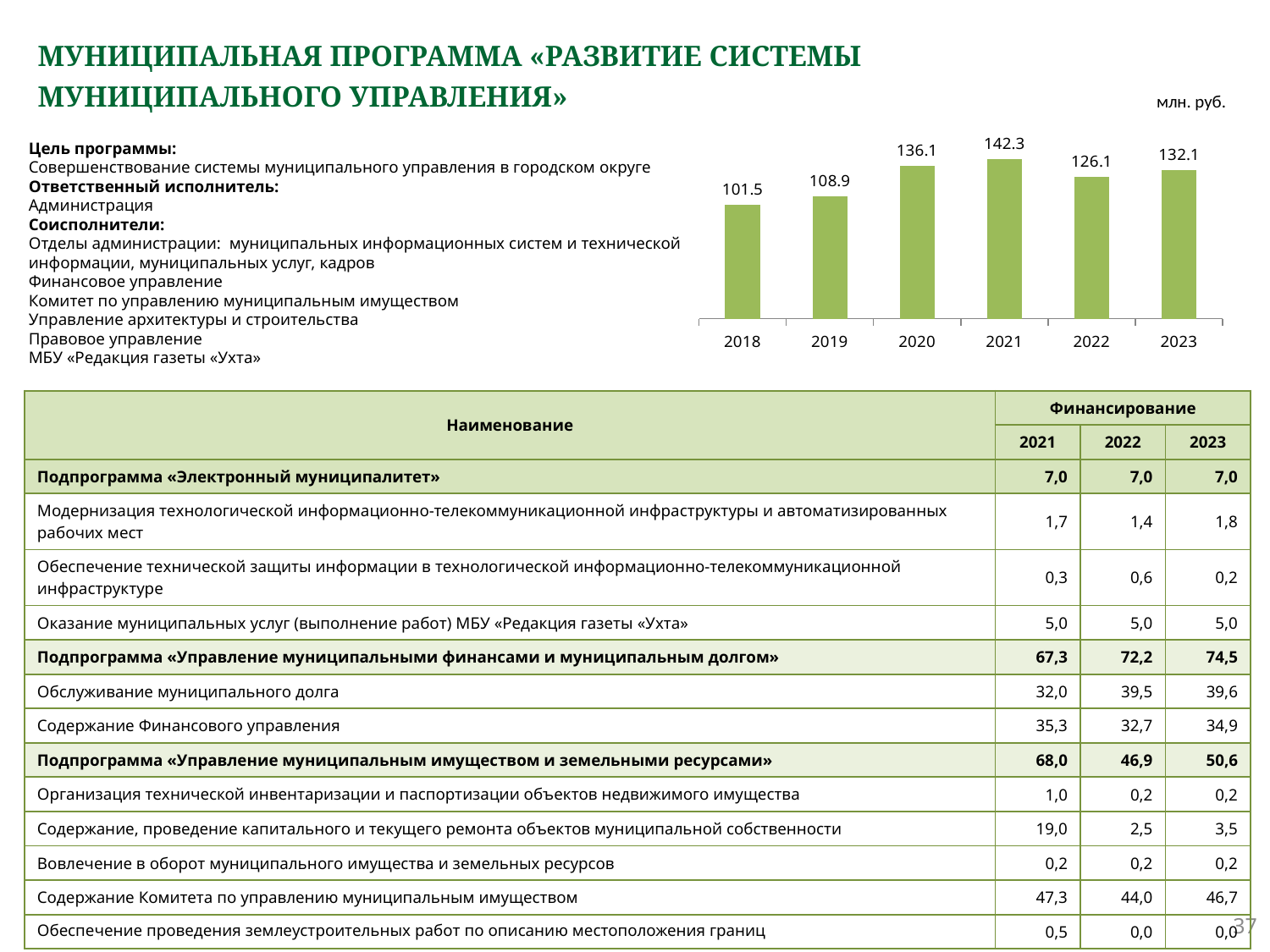
What is the difference between the values for 2019 and 2018 on the bar chart? 7.4 Which is larger on the bar chart, the value for 2020 or the value for 2023? 2020 Which year has the highest value on the bar chart? 2021 What is the difference between the values for 2021 and 2022 on the bar chart? 16.2 What is the value shown for 2018 on the bar chart? 101.5 What kind of chart is shown on the slide? bar chart Which year has the lowest value on the bar chart? 2018 How many years are shown on the bar chart? 6 Does the value on the bar chart rise or fall from 2018 to 2020? rise What is the value shown for 2021 on the bar chart? 142.3 What unit is indicated for the values on the bar chart? млн. руб. What is the value shown for 2022 on the bar chart? 126.1